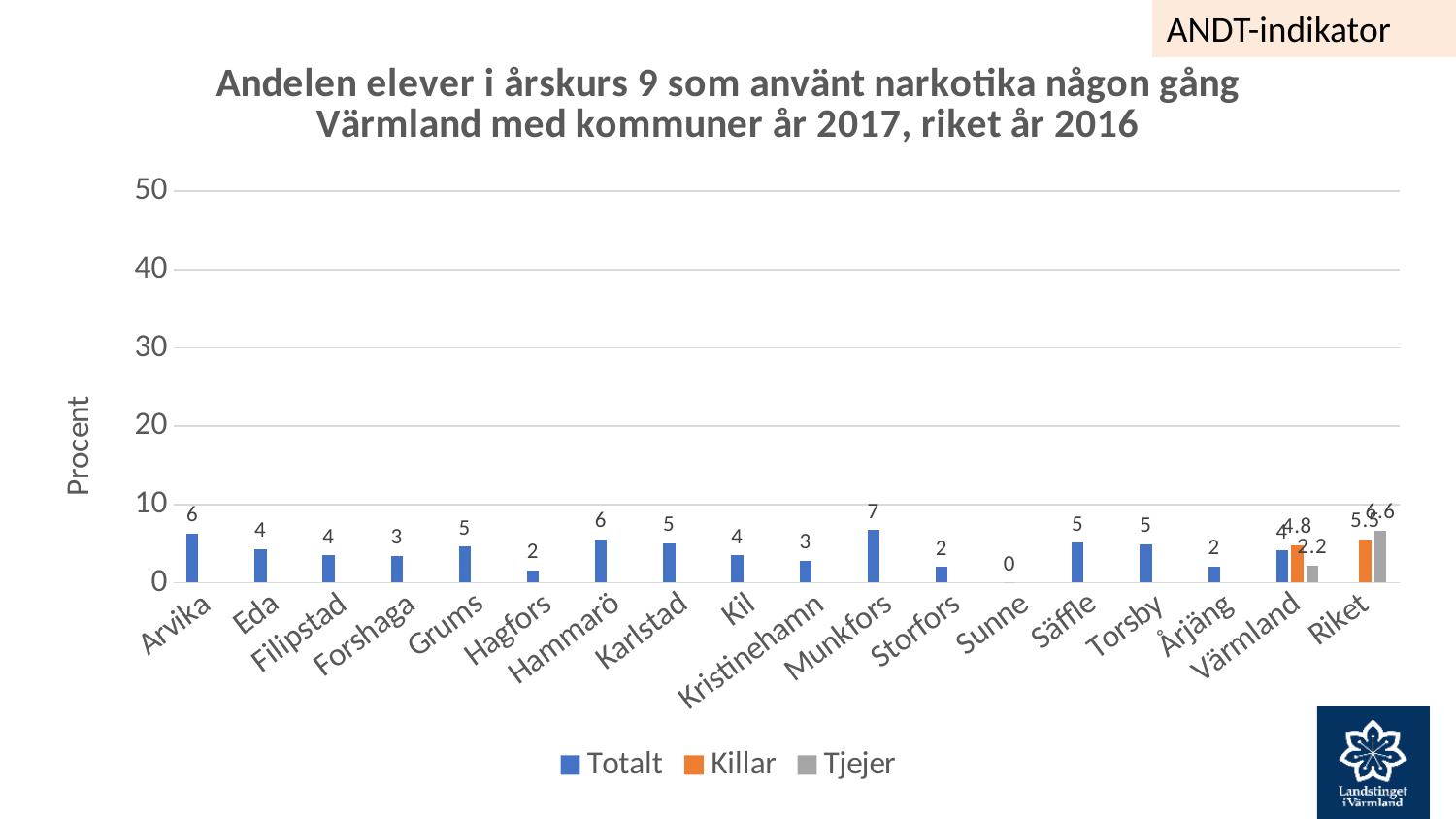
What is the Totalt value for Munkfors? 7 Which category has the lowest Totalt value? Sunne How many categories are shown on the x axis? 18 Is the Totalt value for Munkfors greater or less than 10? less What is the difference between the Totalt values for Arvika and Eda? 2 What is the Killar value for Värmland? 4.8 What is the Totalt value for Hagfors? 2 What kind of chart is shown on the slide? Bar chart What is the Tjejer value for Värmland? 2.2 How many series does the legend list? 3 Which has a larger Totalt value, Hammarö or Kristinehamn? Hammarö Which municipality has the highest Totalt value? Munkfors